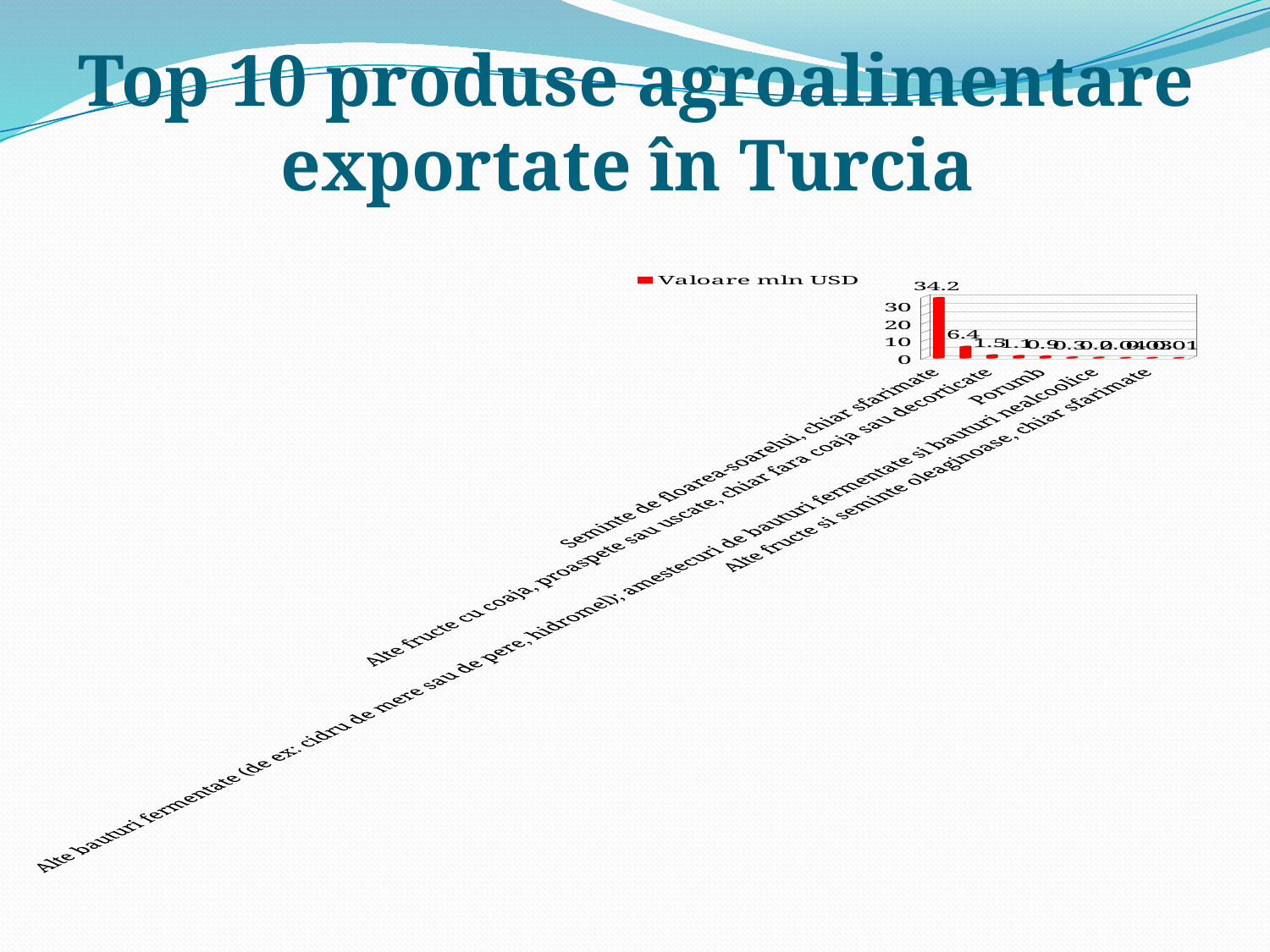
What is the title of the slide containing the chart? Top 10 produse agroalimentare exportate în Turcia How many series does the chart legend list? 1 Do the values rise or fall from left to right along the x axis? fall Is the value for Seminte de floarea-soarelui, chiar sfarimate greater or less than 30? greater What is the second highest value shown in the chart? 6.4 What type of chart is shown on the slide? bar chart What is the difference between the highest value (34.2) and the second highest value (6.4)? 27.8 Is the value for Porumb greater or less than 10? less What is the value for Seminte de floarea-soarelui, chiar sfarimate? 34.2 What is the name of the series shown in the chart legend? Valoare mln USD Which category has the highest value in the chart? Seminte de floarea-soarelui, chiar sfarimate What is the highest value shown in the chart? 34.2